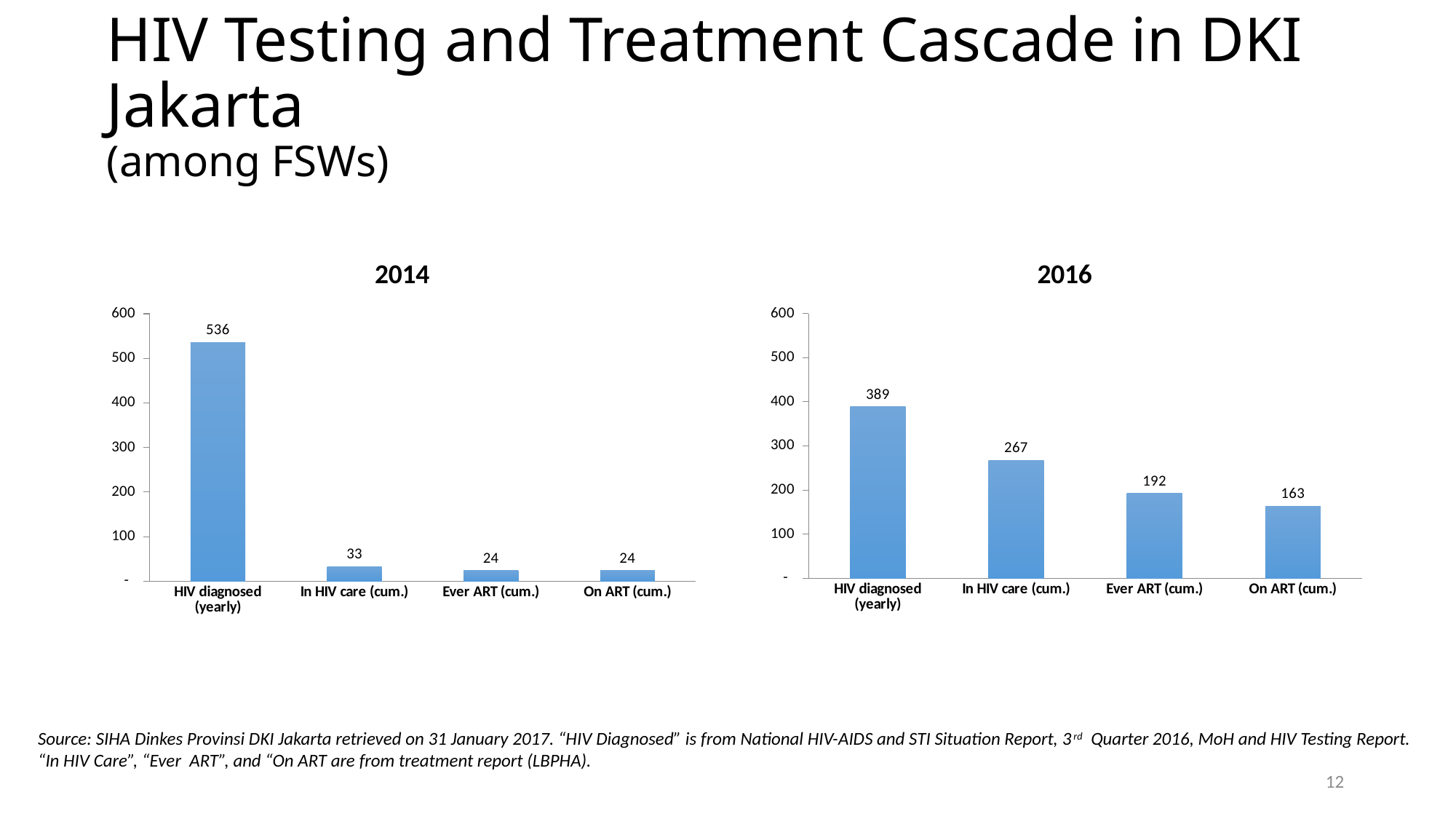
In the 2016 chart, do the values rise or fall from left to right along the x axis? Fall In the 2014 chart, what is the value for In HIV care (cum.)? 33 In the 2014 chart, what is the difference between HIV diagnosed (yearly) and In HIV care (cum.)? 503 In the 2014 chart, what is the value for HIV diagnosed (yearly)? 536 What kind of chart is the 2014 chart? Bar chart In the 2014 chart, which category has the highest value? HIV diagnosed (yearly) How many categories are shown in the 2016 chart? 4 In the 2016 chart, which category has the lowest value? On ART (cum.) In the 2016 chart, what is the value for In HIV care (cum.)? 267 In the 2016 chart, what is the value for On ART (cum.)? 163 In the 2016 chart, what is the difference between HIV diagnosed (yearly) and In HIV care (cum.)? 122 Which is larger: HIV diagnosed (yearly) in the 2014 chart or HIV diagnosed (yearly) in the 2016 chart? 2014 chart